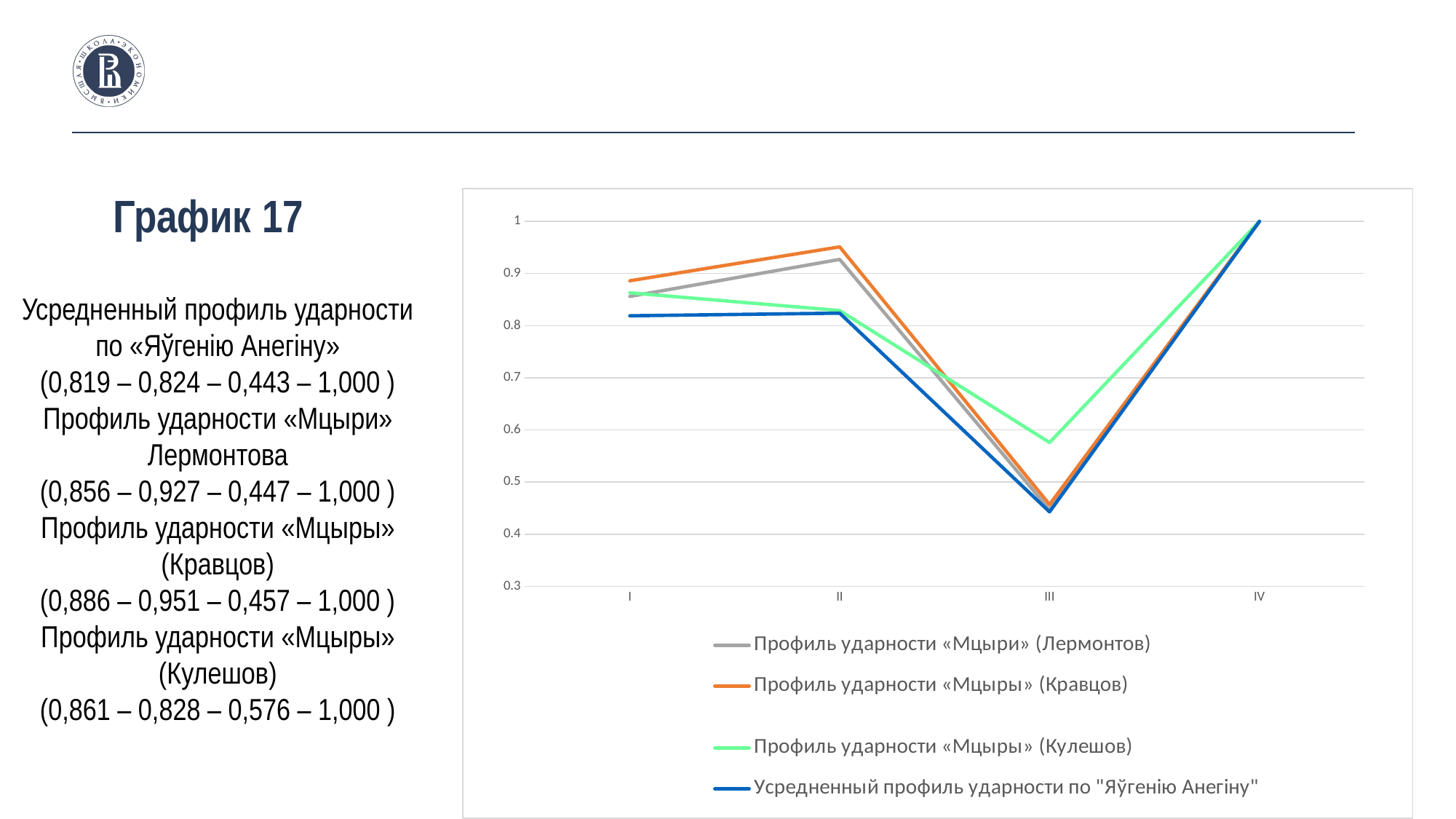
Is the value for Профиль ударности «Мцыры» (Кулешов) at position III greater or less than 0.5? greater According to the slide text, what is the value of Профиль ударности «Мцыры» (Кулешов) at position III? 0,576 Do the values of all series rise or fall from position II to position III? fall Is the value for Профиль ударности «Мцыри» (Лермонтов) at position III greater or less than 0.5? less How many series does the chart legend list? 4 What value do all four series reach at position IV? 1 What colour is the line for Профиль ударности «Мцыры» (Кравцов)? orange What type of chart is shown on the slide? line chart At position II, which is larger: Профиль ударности «Мцыры» (Кравцов) or Профиль ударности «Мцыры» (Кулешов)? Профиль ударности «Мцыры» (Кравцов) Which series has the highest value at position III? Профиль ударности «Мцыры» (Кулешов) How many points are plotted along the x axis for each series? 4 Which series has the lowest value at position I? Усредненный профиль ударности по "Яўгенію Анегіну"